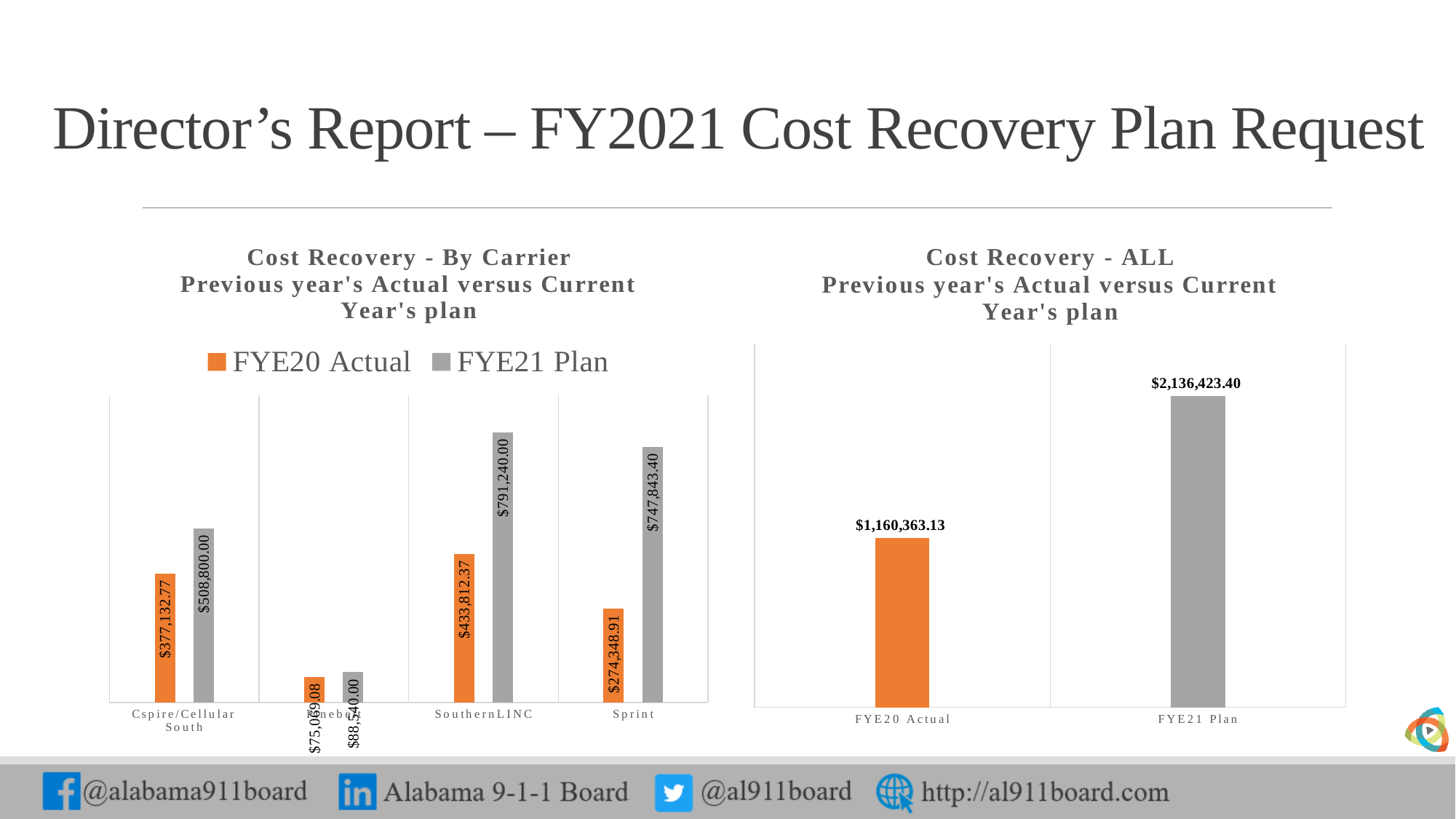
In the 'Cost Recovery - By Carrier' chart, what is the FYE20 Actual value for Cspire/Cellular South? $377,132.77 In the 'Cost Recovery - By Carrier' chart, which carrier has the highest FYE21 Plan value? SouthernLINC In the 'Cost Recovery - By Carrier' chart, which is larger: the FYE21 Plan for Cspire/Cellular South or the FYE21 Plan for Sprint? Sprint What type of chart is the 'Cost Recovery - ALL' chart? Bar chart In the 'Cost Recovery - By Carrier' chart, what is the difference between the FYE21 Plan and FYE20 Actual values for Sprint? $473,494.49 In the 'Cost Recovery - By Carrier' chart, what is the FYE21 Plan value for SouthernLINC? $791,240.00 In the 'Cost Recovery - By Carrier' chart, what is the FYE20 Actual value for Sprint? $274,348.91 How many series does the legend of the 'Cost Recovery - By Carrier' chart list? 2 In the 'Cost Recovery - ALL' chart, what is the difference between the FYE21 Plan and the FYE20 Actual values? $976,060.27 In the 'Cost Recovery - By Carrier' chart, what is the difference between the FYE21 Plan and FYE20 Actual values for Cspire/Cellular South? $131,667.23 How many carrier categories are shown in the 'Cost Recovery - By Carrier' chart? 4 In the 'Cost Recovery - ALL' chart, what is the FYE21 Plan value? $2,136,423.40